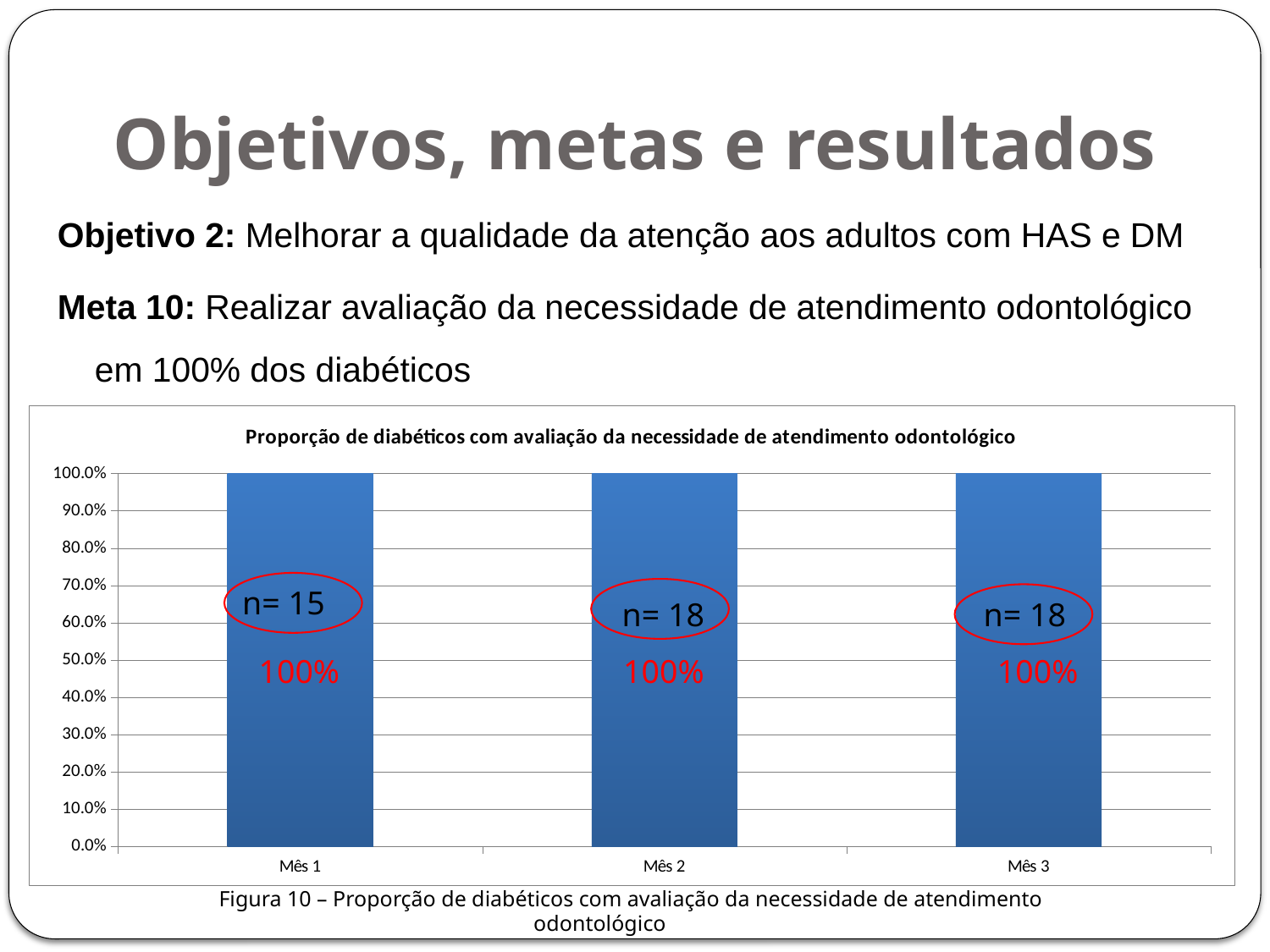
How many months (categories) are shown on the x axis of the chart? 3 What kind of chart is shown on the slide? bar chart What is the title of the chart? Proporção de diabéticos com avaliação da necessidade de atendimento odontológico What is the value for Mês 2 in the chart? 100% What is the value for Mês 1 in the chart? 100% Is the value for Mês 2 greater or less than 90.0%? greater What is the difference between the values for Mês 1 and Mês 3? 0% What is the value for Mês 3 in the chart? 100% What is the n value annotated on the bar for Mês 1? n= 15 What is the n value annotated on the bar for Mês 3? n= 18 What is the highest tick value shown on the y axis of the chart? 100.0% Do the values rise, fall or stay the same from Mês 1 to Mês 3? stay the same